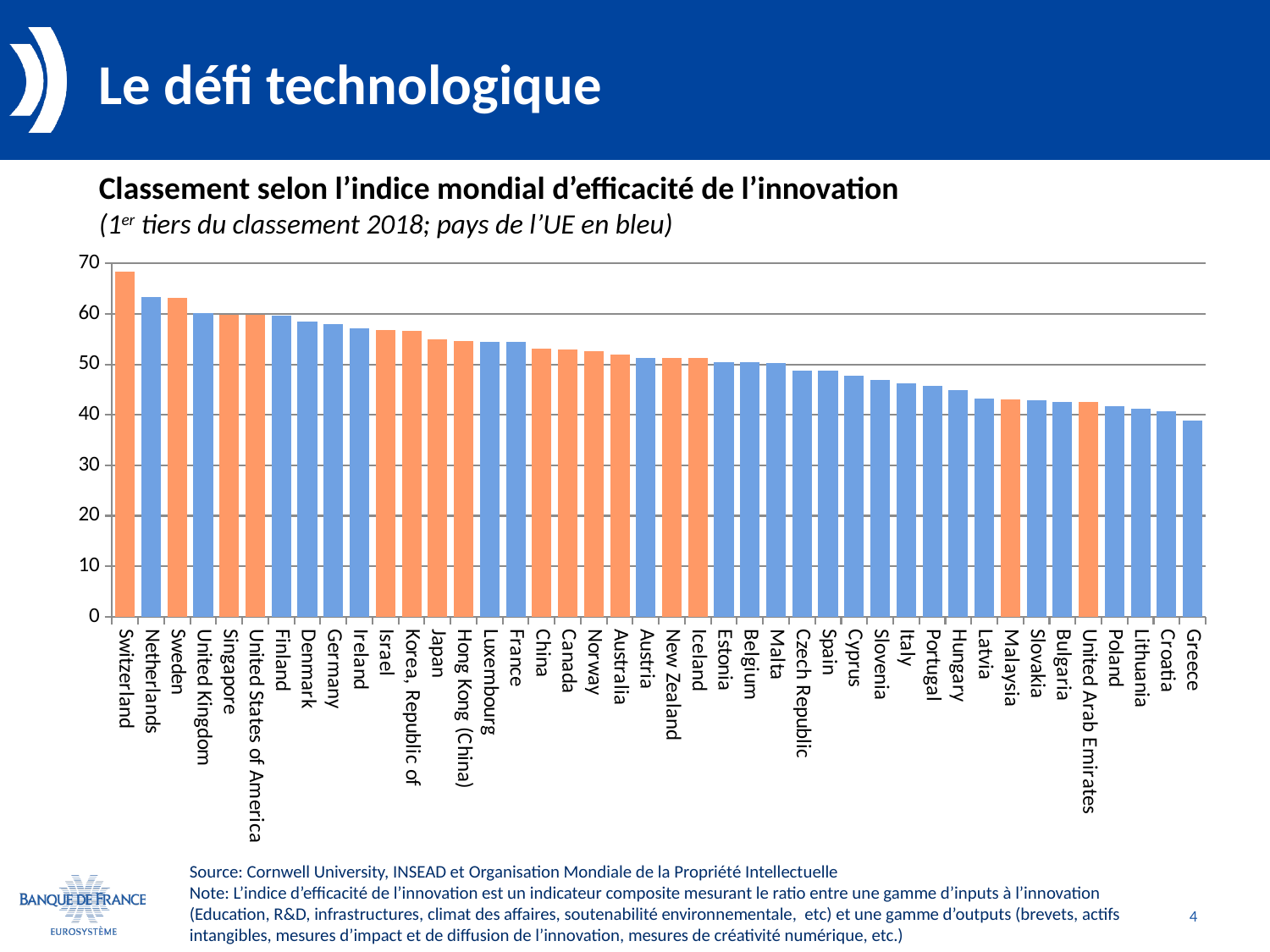
Which country has the lowest value in the chart? Greece What kind of chart is shown on the slide? bar chart Is the value for Hungary greater or less than 50? less Which has the larger value, Japan or Spain? Japan Is the value for Greece greater or less than 40? less How many countries are shown in the chart? 42 Is the value for Germany greater or less than 60? less Which country has the highest value in the chart? Switzerland Do the values rise or fall from left to right along the x axis? fall According to the subtitle, what colour are the EU countries shown in? blue